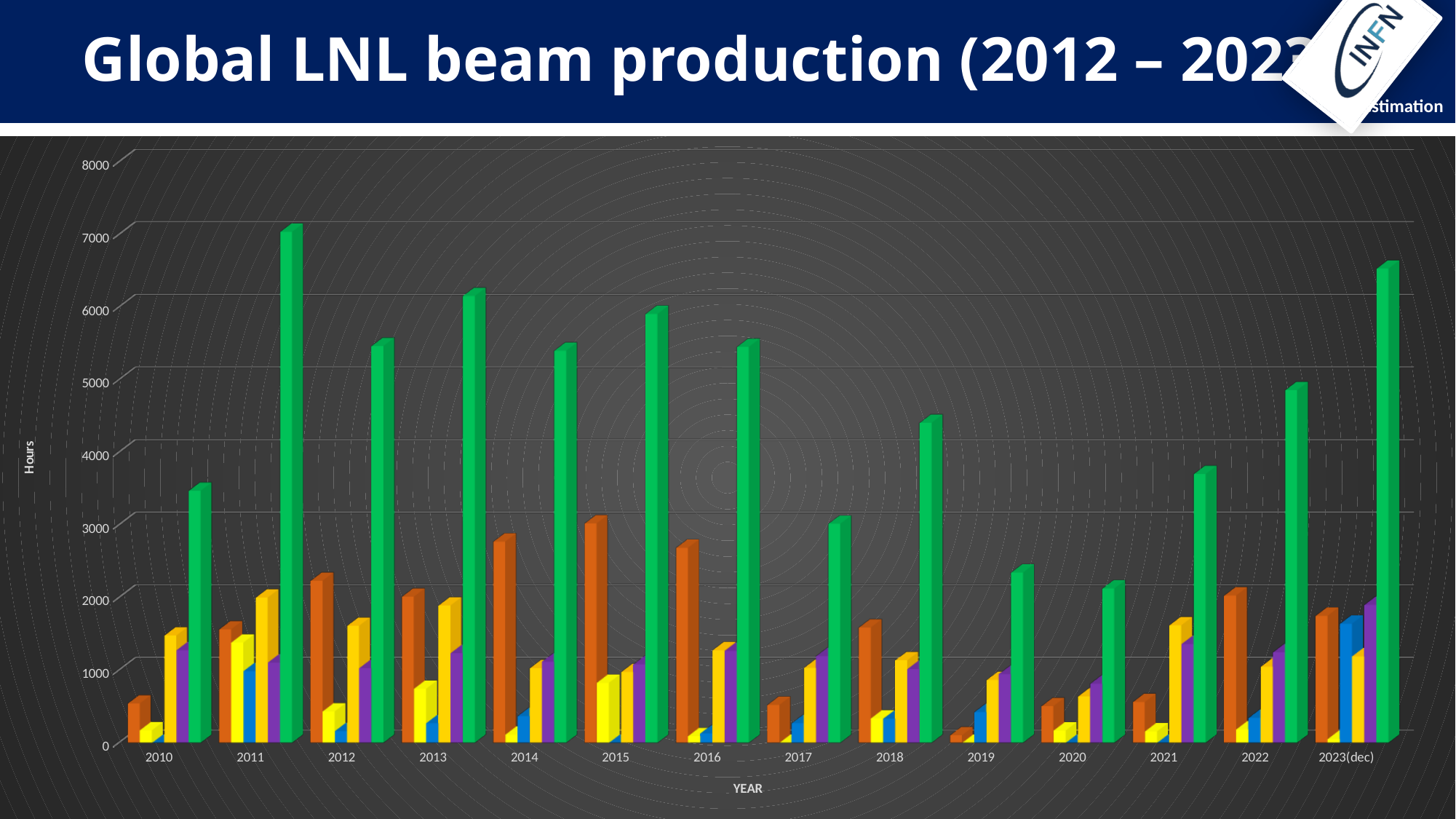
In which year is the orange bar the shortest? 2019 Is the green bar for 2018 greater or less than 4000? greater Is the green bar for 2023(dec) greater or less than 6000? greater Do the green bars rise or fall from 2020 to 2023(dec)? rise How many years (categories) are shown on the x axis? 14 In which year is the green bar the tallest? 2011 Which is taller, the green bar for 2012 or the green bar for 2013? 2013 Is the green bar for 2021 greater or less than 4000? less What is the label of the vertical axis? Hours What is the label of the horizontal axis? YEAR What kind of chart is shown on the slide? bar chart